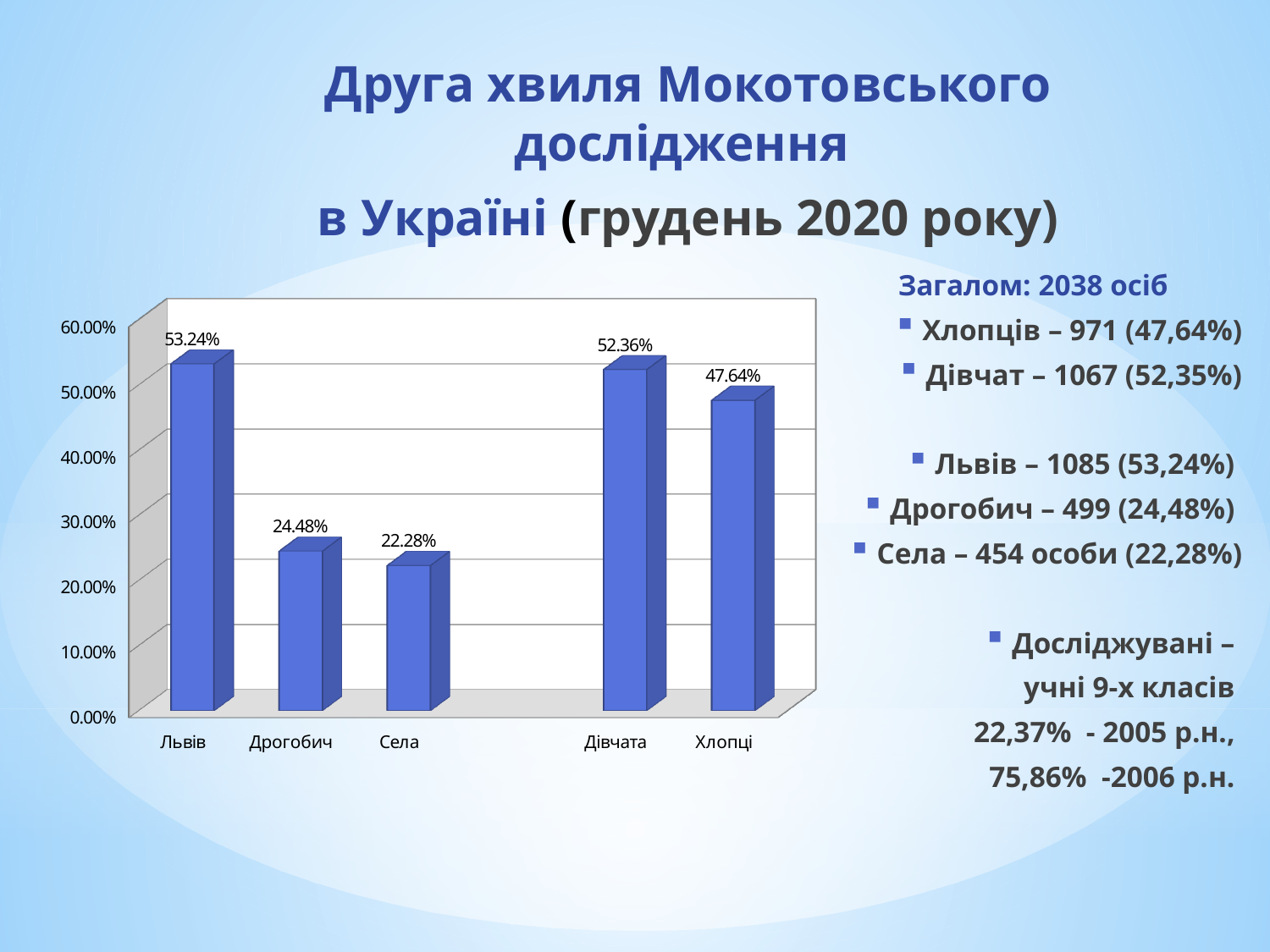
Which is larger, the value for Дрогобич or the value for Села? Дрогобич What is the value for Дівчата? 52.36% What is the value for Львів? 53.24% Which category has the lowest value? Села What kind of chart is shown on the slide? Bar chart How many bars are plotted in the chart? 5 Which category has the highest value? Львів What is the value for Дрогобич? 24.48% What is the difference between the values for Дівчата and Хлопці? 4.72% What is the difference between the values for Львів and Дрогобич? 28.76% What is the value for Хлопці? 47.64% What is the value for Села? 22.28%